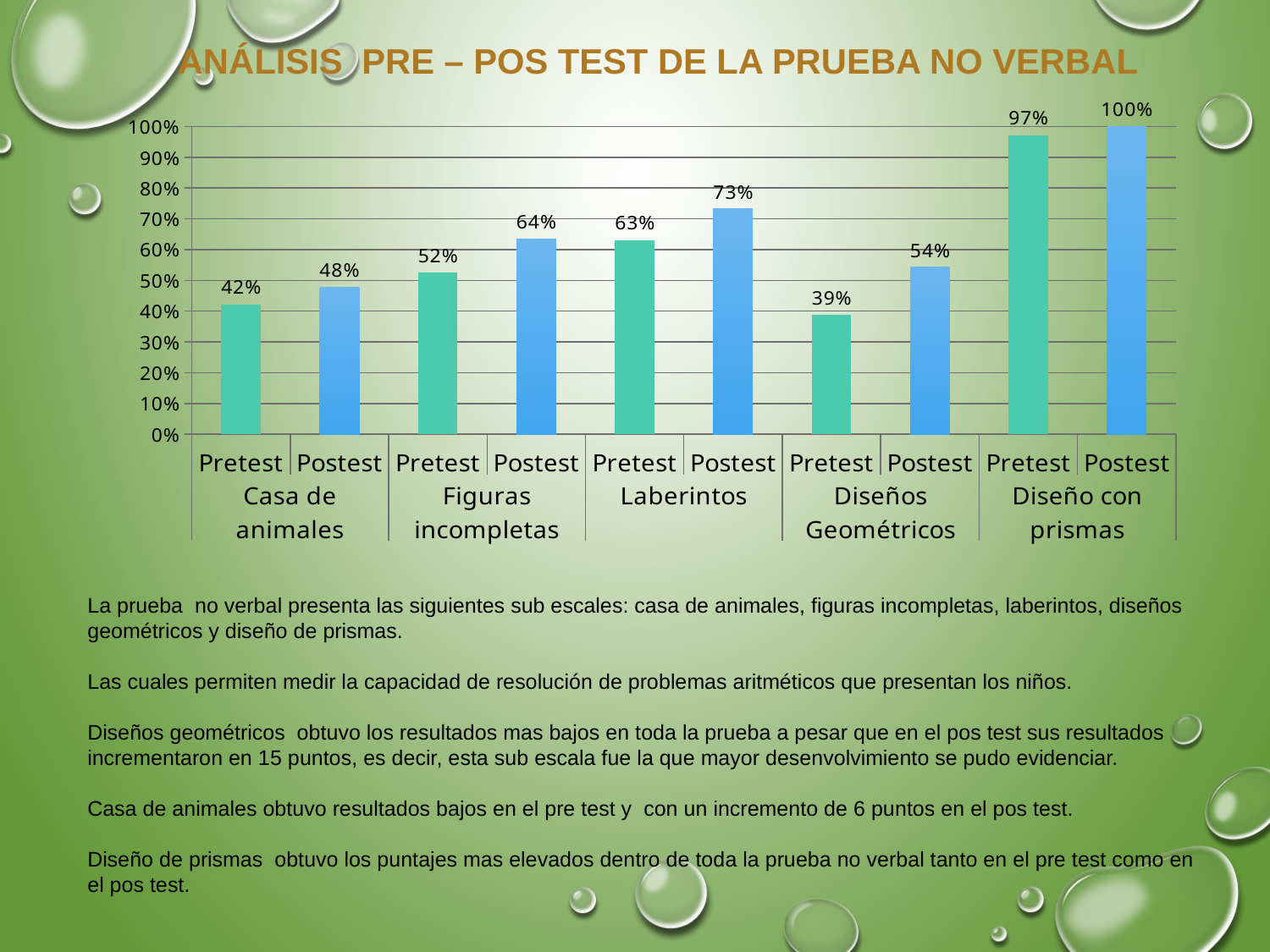
Which bar has the highest value in the chart? Postest, Diseño con prismas (100%) What is the title of the slide containing the chart? ANÁLISIS PRE – POS TEST DE LA PRUEBA NO VERBAL What is the difference between the Postest and Pretest values for Casa de animales? 6% What is the Postest value for Laberintos? 73% What kind of chart is shown on the slide? Bar chart What is the Pretest value for Casa de animales? 42% What is the Postest value for Figuras incompletas? 64% What is the difference between the Postest and Pretest values for Diseños Geométricos? 15% Which is larger, the Pretest value for Laberintos or the Postest value for Figuras incompletas? Postest value for Figuras incompletas (64%) Which bar has the lowest value in the chart? Pretest, Diseños Geométricos (39%) What is the Pretest value for Diseños Geométricos? 39% How many bars are plotted in the chart? 10